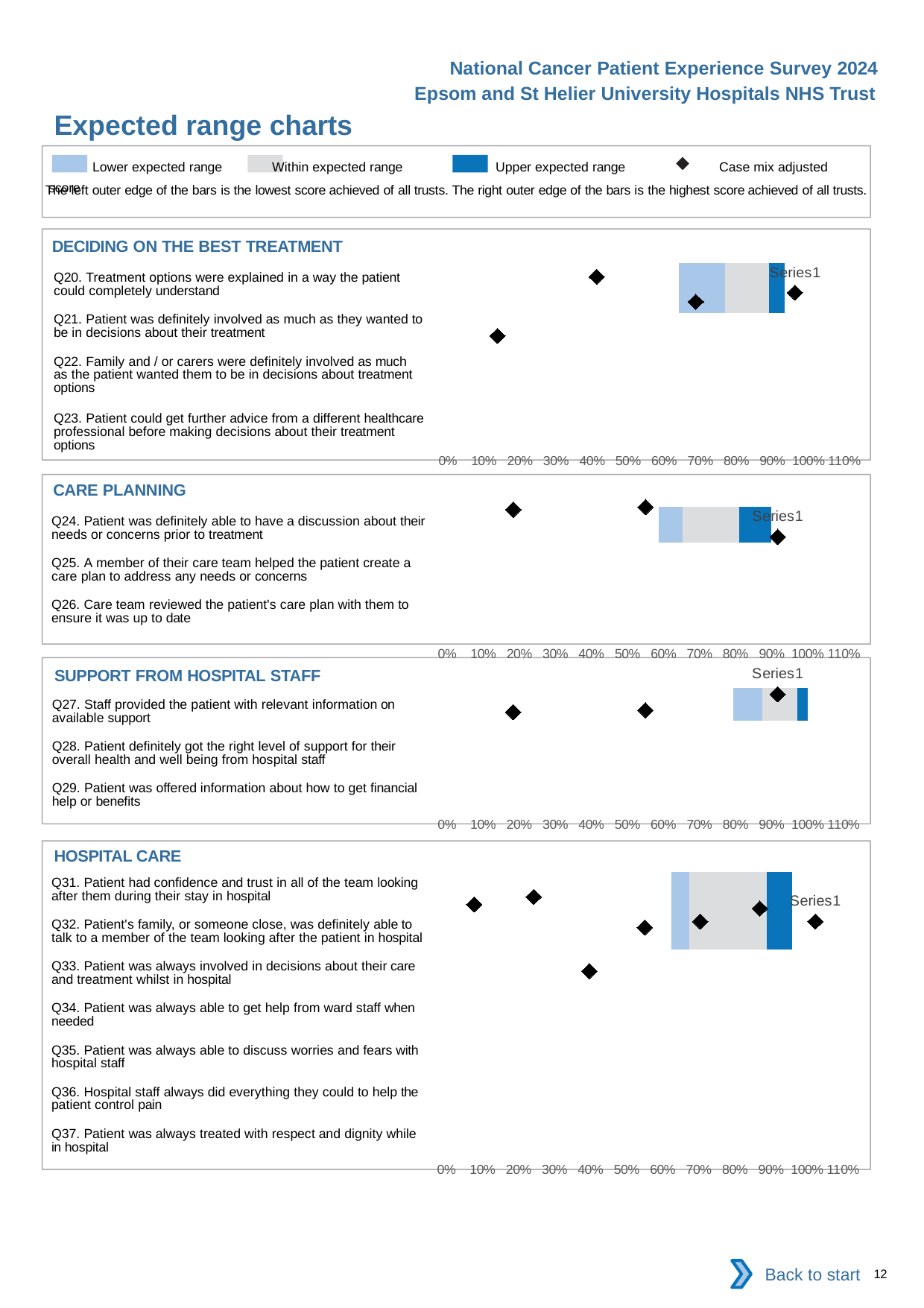
According to the legend, which colour represents the upper expected range? Dark blue In the 'Care planning' chart, what is the label of the first listed category? Q24. Patient was definitely able to have a discussion about their needs or concerns prior to treatment In the 'Hospital care' chart, how many survey questions are listed as categories? 7 In the 'Deciding on the best treatment' chart, how many survey questions are listed as categories? 4 In the 'Hospital care' chart, what is the highest percentage tick shown on the x axis? 110% In the 'Care planning' chart, how many survey questions are listed as categories? 3 How many entries does the shared legend at the top of the slide list? 4